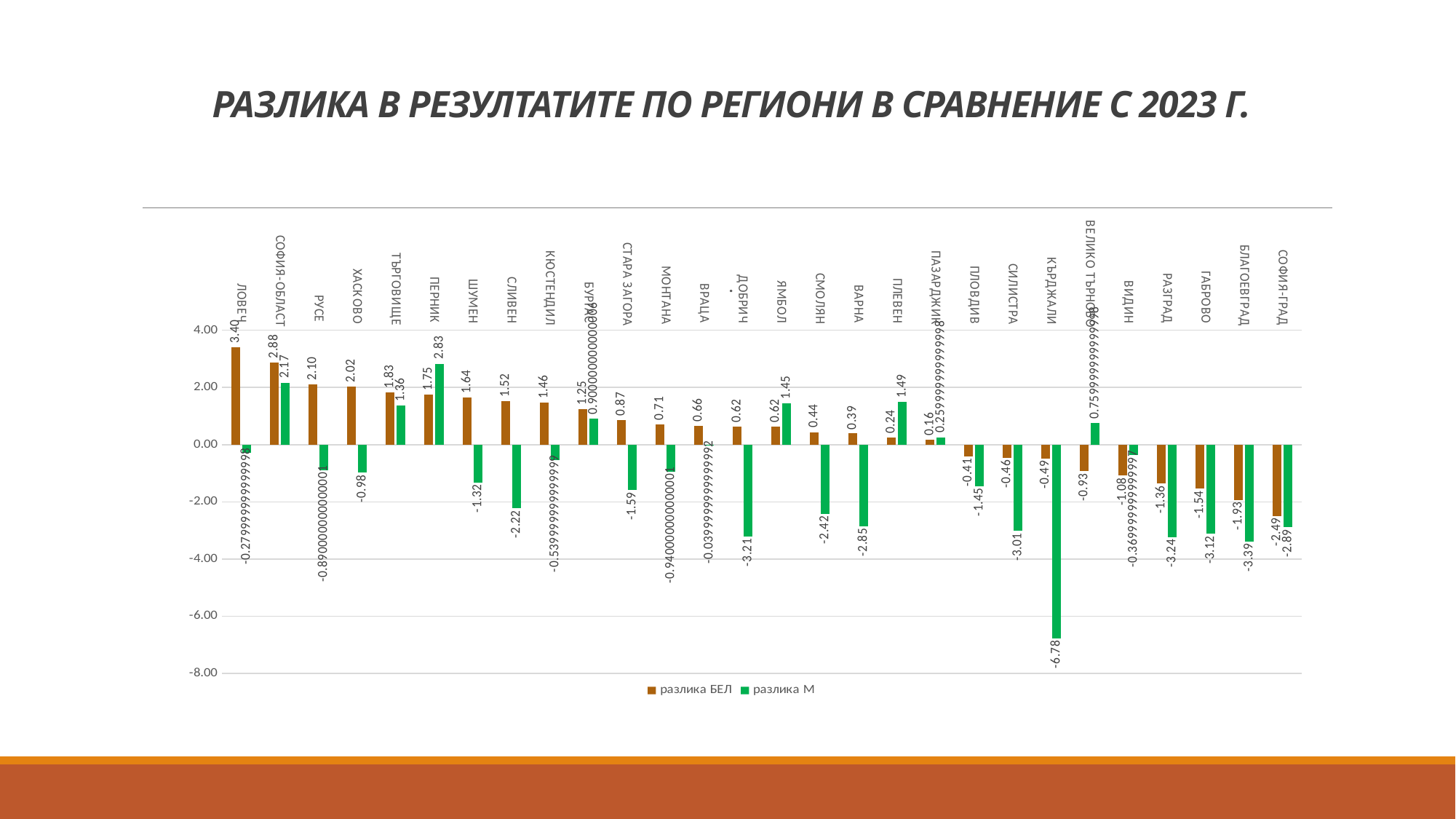
What is the difference between the разлика БЕЛ values for ЛОВЕЧ and СОФИЯ-ОБЛАСТ? 0.52 What is the value of разлика БЕЛ for ЛОВЕЧ? 3.40 Which region has the highest value for разлика БЕЛ? ЛОВЕЧ Which is larger, the разлика М value for ДОБРИЧ or for СМОЛЯН? СМОЛЯН How many series does the legend list? 2 What kind of chart is shown on the slide? bar chart Which region has the lowest value for разлика БЕЛ? СОФИЯ-ГРАД Which region has the lowest value for разлика М? КЪРДЖАЛИ What is the value of разлика М for КЪРДЖАЛИ? -6.78 Is the разлика М value for БЛАГОЕВГРАД greater or less than -2.00? less How many regions are shown on the x axis? 28 What is the value of разлика М for ПЕРНИК? 2.83